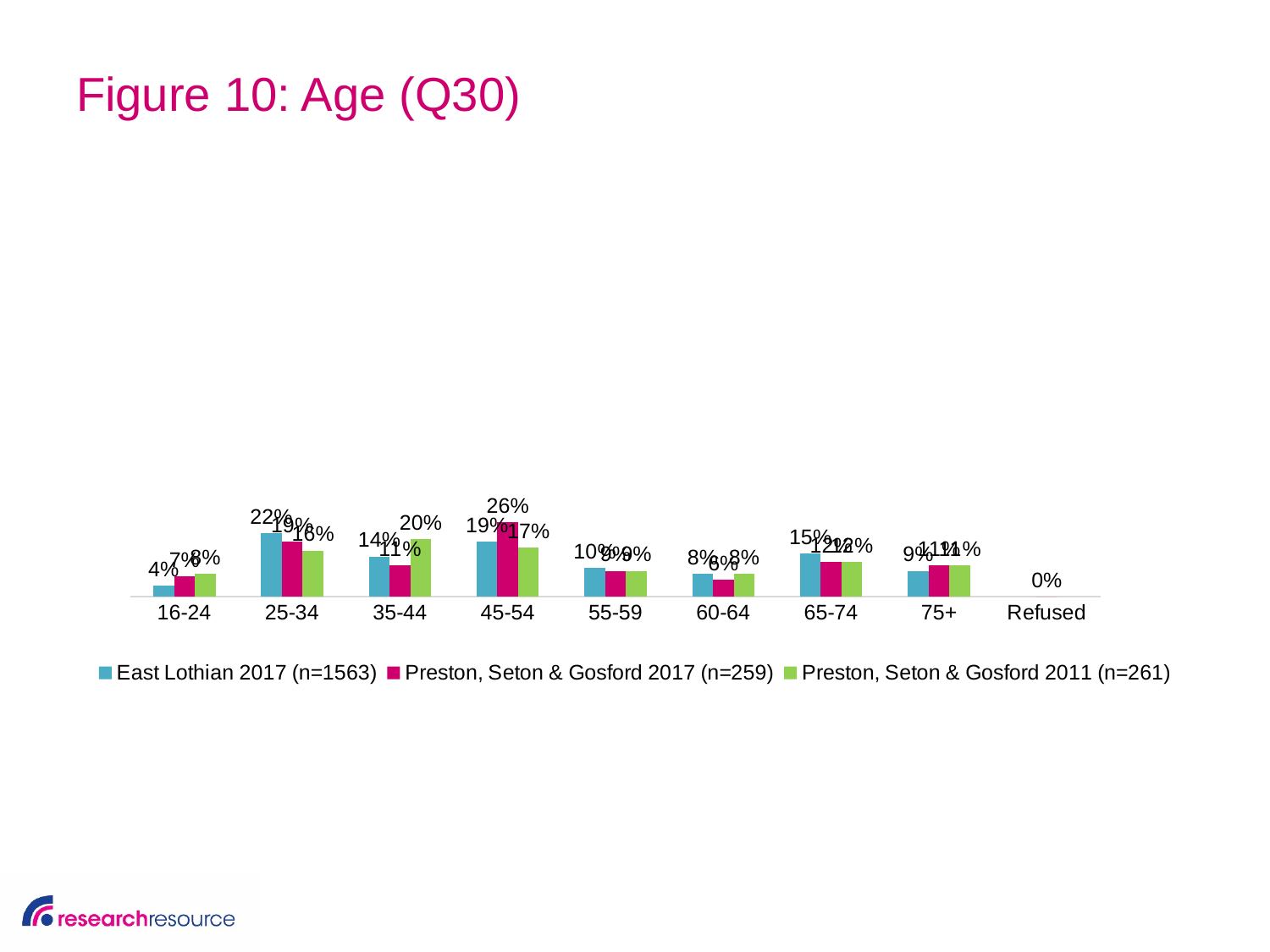
How many age categories are shown on the x axis? 9 Which age group has the highest value for the Preston, Seton & Gosford 2017 series? 45-54 What value is shown for the Refused category? 0% What is the value for Preston, Seton & Gosford 2011 in the 35-44 age group? 20% What is the value for Preston, Seton & Gosford 2017 in the 45-54 age group? 26% What is the value for East Lothian 2017 in the 16-24 age group? 4% In the 35-44 age group, which is larger: East Lothian 2017 or Preston, Seton & Gosford 2011? Preston, Seton & Gosford 2011 What kind of chart is shown on the slide? Bar chart What is the value for East Lothian 2017 in the 25-34 age group? 22% In the 45-54 age group, what is the difference between Preston, Seton & Gosford 2017 and East Lothian 2017? 7 percentage points Which age group has the highest value for the East Lothian 2017 series? 25-34 How many series does the legend list? 3